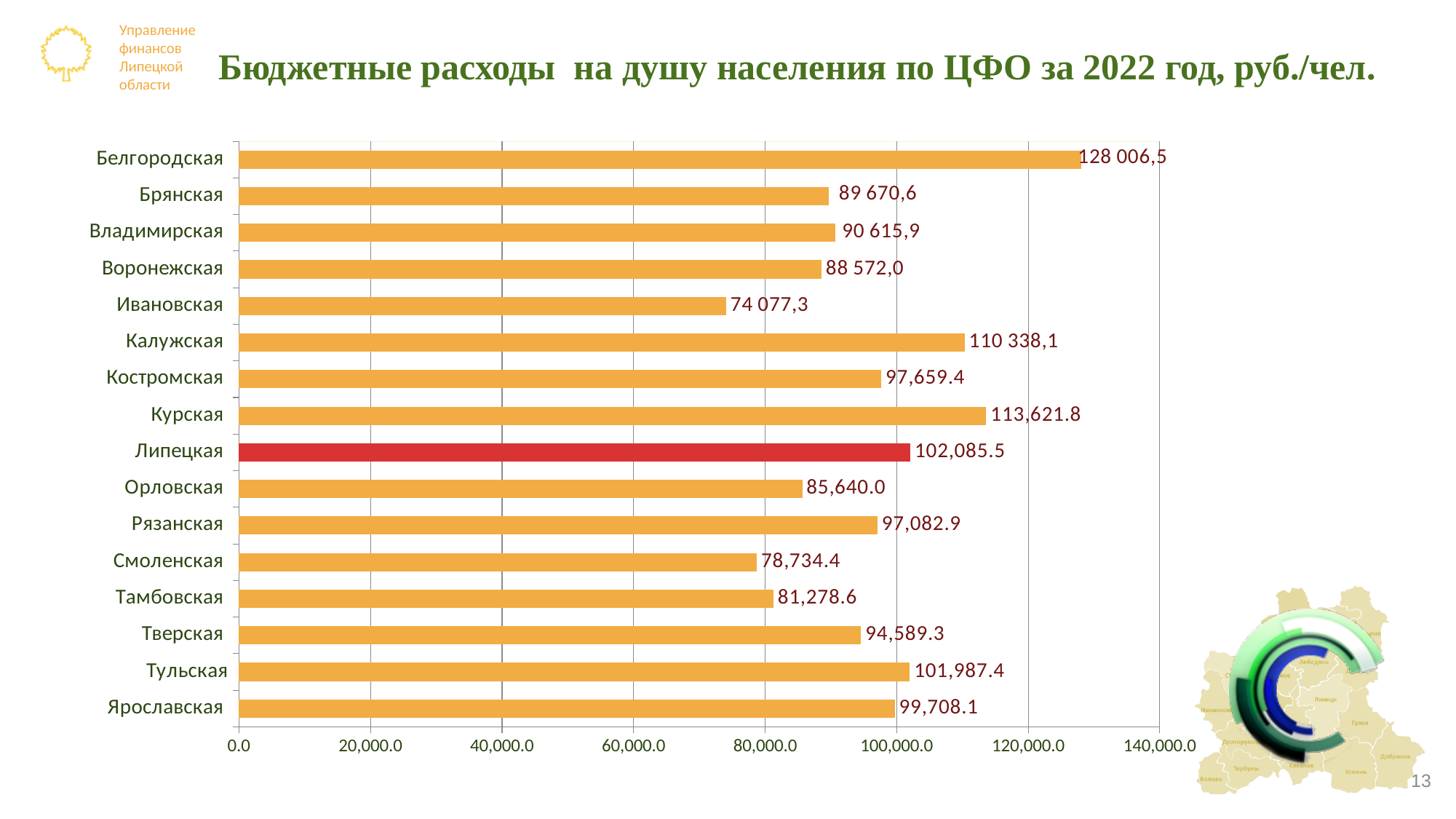
What is the value for Липецкая? 102,085.5 How many regions are shown in the chart? 16 What is the value for Ивановская? 74 077,3 What kind of chart is shown on the slide? bar chart What is the difference between the values for Курская and Липецкая? 11,536.3 What is the value for Белгородская? 128 006,5 Is the value for Смоленская greater or less than 80,000.0? less Which region has the lowest value? Ивановская Which has the larger value, Калужская or Курская? Курская Which region's bar is shown in a different colour (red) from the others? Липецкая What is the value for Тульская? 101,987.4 Which region has the highest value? Белгородская